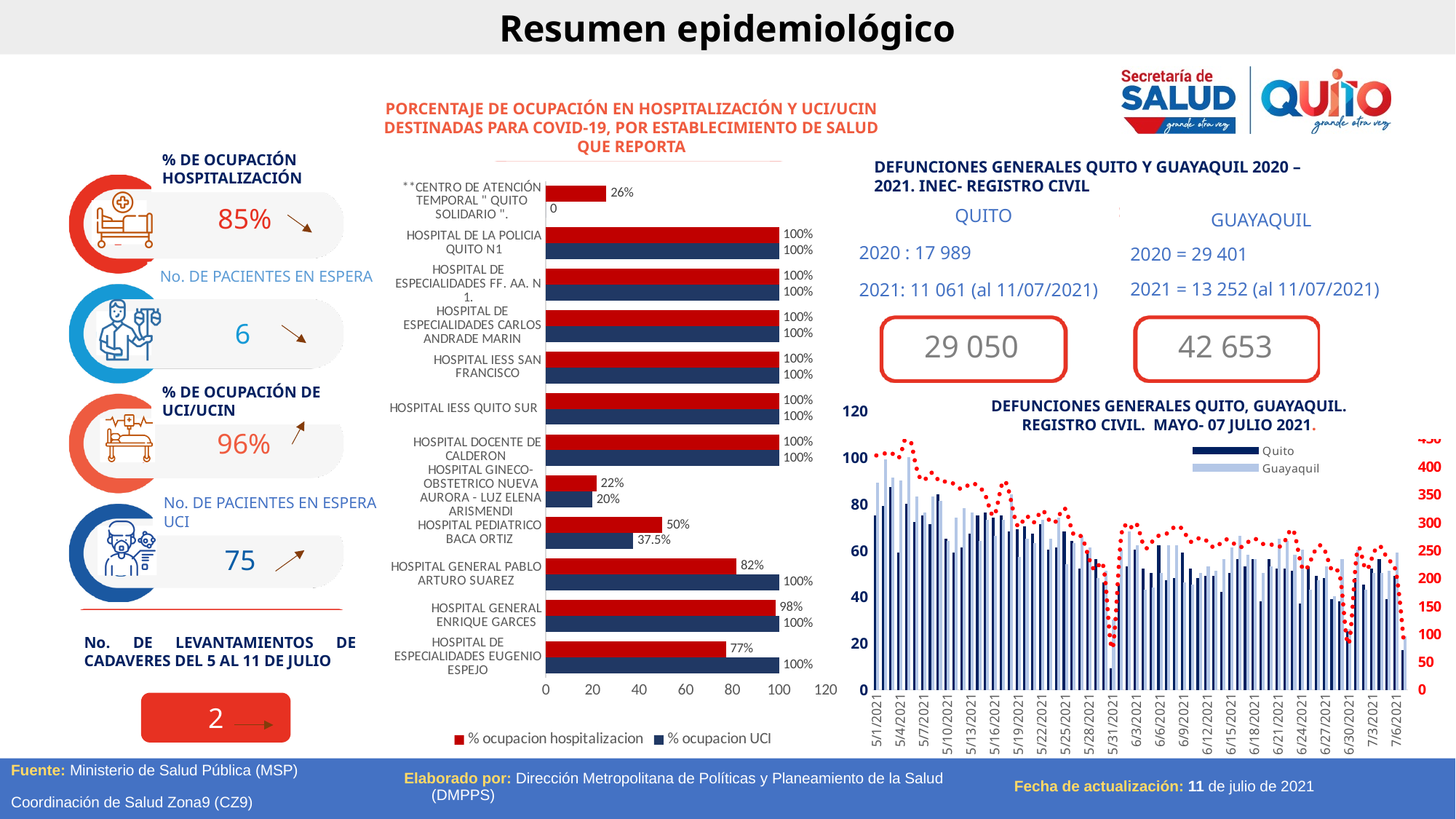
In the chart 'PORCENTAJE DE OCUPACIÓN EN HOSPITALIZACIÓN Y UCI/UCIN', what is the % ocupacion hospitalizacion for the CENTRO DE ATENCIÓN TEMPORAL "QUITO SOLIDARIO"? 26% In the chart 'DEFUNCIONES GENERALES QUITO, GUAYAQUIL. REGISTRO CIVIL. MAYO- 07 JULIO 2021', how many series does the legend list? 2 In the chart 'PORCENTAJE DE OCUPACIÓN EN HOSPITALIZACIÓN Y UCI/UCIN', which establishment has the lowest % ocupacion hospitalizacion? HOSPITAL GINECO-OBSTETRICO NUEVA AURORA - LUZ ELENA ARISMENDI In the chart 'DEFUNCIONES GENERALES QUITO, GUAYAQUIL. REGISTRO CIVIL. MAYO- 07 JULIO 2021', which series is shown in dark navy bars? Quito In the chart 'PORCENTAJE DE OCUPACIÓN EN HOSPITALIZACIÓN Y UCI/UCIN', how many establishments are listed? 12 In the chart 'PORCENTAJE DE OCUPACIÓN EN HOSPITALIZACIÓN Y UCI/UCIN', what is the difference between the % ocupacion UCI and the % ocupacion hospitalizacion for HOSPITAL DE ESPECIALIDADES EUGENIO ESPEJO? 23% What kind of chart is 'PORCENTAJE DE OCUPACIÓN EN HOSPITALIZACIÓN Y UCI/UCIN'? Bar chart In the chart 'PORCENTAJE DE OCUPACIÓN EN HOSPITALIZACIÓN Y UCI/UCIN', what is the % ocupacion hospitalizacion for HOSPITAL GENERAL PABLO ARTURO SUAREZ? 82% In the chart 'PORCENTAJE DE OCUPACIÓN EN HOSPITALIZACIÓN Y UCI/UCIN', what is the % ocupacion hospitalizacion for HOSPITAL PEDIATRICO BACA ORTIZ? 50% In the chart 'PORCENTAJE DE OCUPACIÓN EN HOSPITALIZACIÓN Y UCI/UCIN', which is larger for HOSPITAL GENERAL ENRIQUE GARCES: % ocupacion hospitalizacion or % ocupacion UCI? % ocupacion UCI In the chart 'PORCENTAJE DE OCUPACIÓN EN HOSPITALIZACIÓN Y UCI/UCIN', what is the % ocupacion UCI for HOSPITAL PEDIATRICO BACA ORTIZ? 37.5% In the chart 'PORCENTAJE DE OCUPACIÓN EN HOSPITALIZACIÓN Y UCI/UCIN', how many series does the legend list? 2